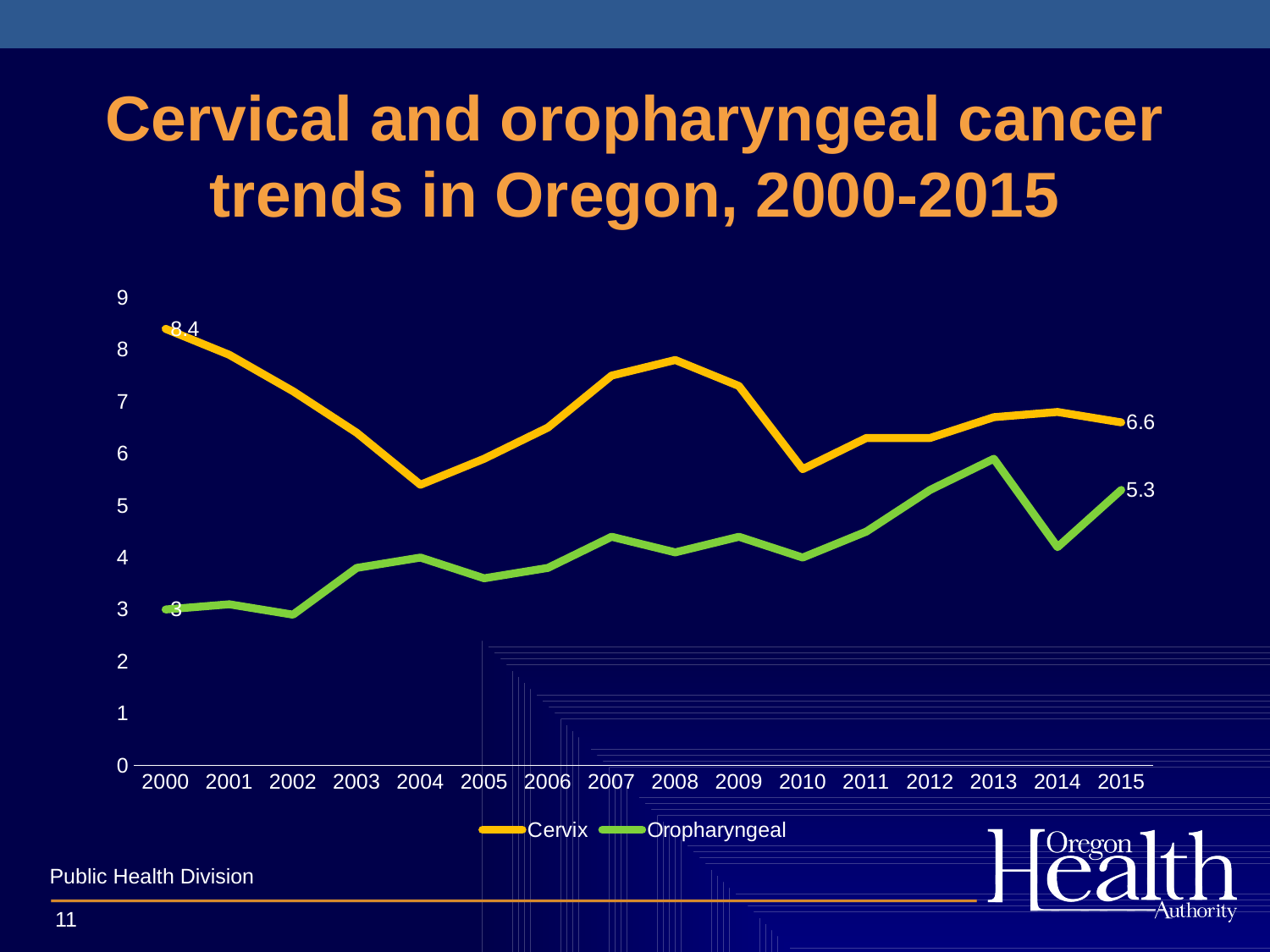
What kind of chart is shown on the slide? Line chart What is the Oropharyngeal value in 2000? 3 How many series does the legend list? 2 What is the Cervix value in 2015? 6.6 By how much did the Cervix value fall from 2000 to 2015? 1.8 Is the Cervix value for 2004 greater or less than 6? less Is the Oropharyngeal value for 2013 greater or less than 5? greater What is the Cervix value in 2000? 8.4 What is the difference between the Cervix and Oropharyngeal values in 2015? 1.3 How many years are shown on the x axis? 16 In 2015, which series has the higher value, Cervix or Oropharyngeal? Cervix What is the Oropharyngeal value in 2015? 5.3